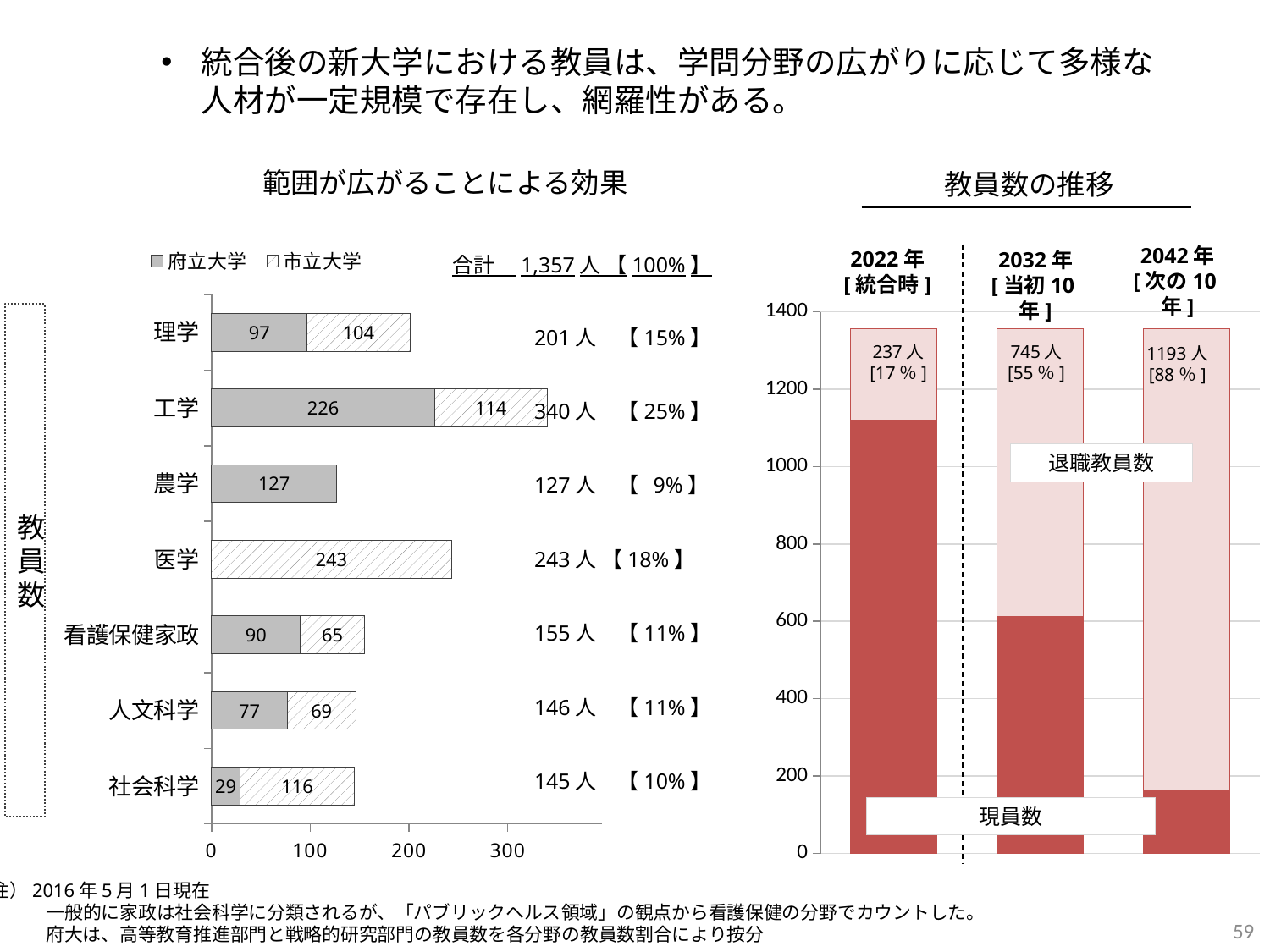
In the chart titled 範囲が広がることによる効果, what share of the total does 医学 represent? 18% What kind of chart is the chart titled 教員数の推移? Stacked bar chart In the chart titled 範囲が広がることによる効果, what is the 市立大学 value for 社会科学? 116 In the chart titled 教員数の推移, what is the number of retiring faculty (退職教員数) shown for 2032 年? 745 人 In the chart titled 範囲が広がることによる効果, which field has the largest total number of faculty? 工学 In the chart titled 教員数の推移, is the 現員数 value for 2022 年 greater or less than 1000? greater In the chart titled 範囲が広がることによる効果, how many fields are listed on the vertical axis? 7 In the chart titled 範囲が広がることによる効果, what is the total for 看護保健家政? 155 人 In the chart titled 範囲が広がることによる効果, what is the difference between the 府立大学 and 市立大学 values for 理学? 7 In the chart titled 範囲が広がることによる効果, how many series does the legend list? 2 In the chart titled 範囲が広がることによる効果, which is larger for 人文科学: the 府立大学 value or the 市立大学 value? 府立大学 In the chart titled 範囲が広がることによる効果, what is the 府立大学 value for 工学? 226